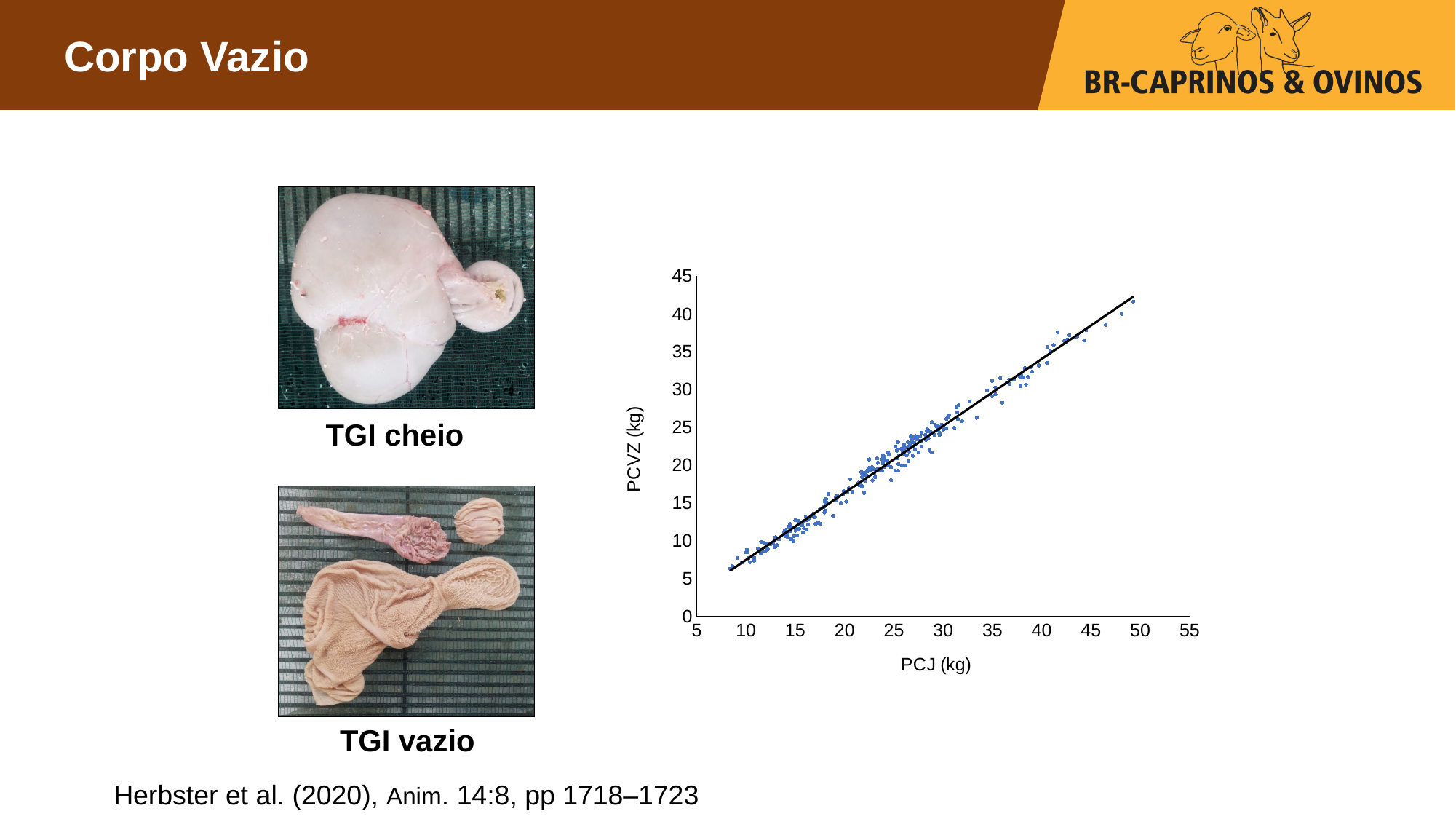
What is the highest value shown on the y axis of the chart? 45 What is the label of the y axis of the chart? PCVZ (kg) Do the PCVZ values rise or fall as PCJ increases along the x axis? Rise Is the PCVZ value of the points at a PCJ of 20 kg greater or less than 25? less Is the PCVZ value of the points at a PCJ of 30 kg greater or less than 20? greater Is the PCVZ value of the points at a PCJ of 50 kg greater or less than 35? greater What kind of chart is shown on the slide? Scatter chart What is the label of the x axis of the chart? PCJ (kg)